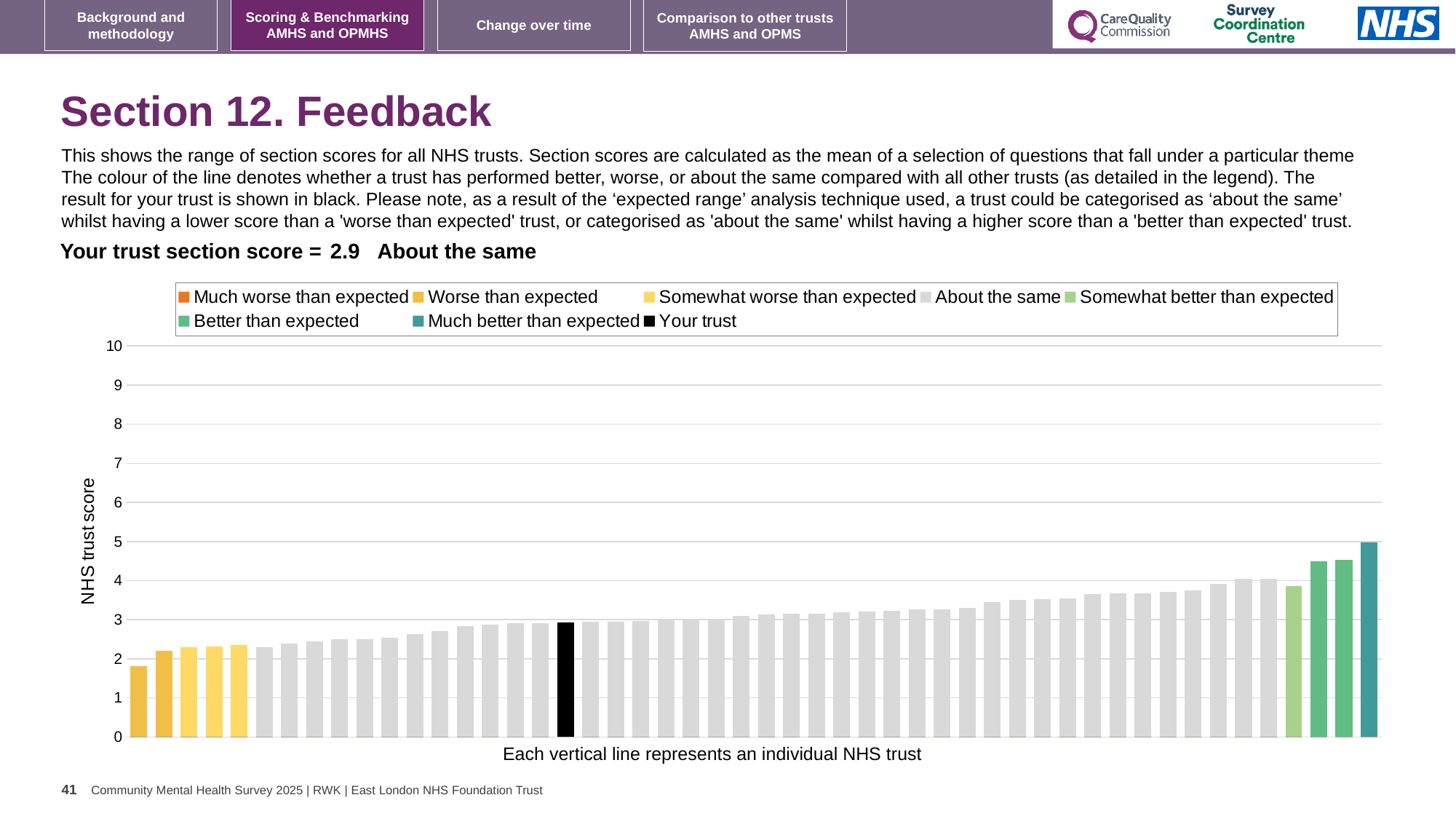
Is the value of the black 'Your trust' bar greater or less than 3? less What colour is used for the 'Your trust' bar in the chart? black What kind of chart is shown on the slide? bar chart What is the section score for your trust shown on the slide? 2.9 What is the label on the vertical axis of the chart? NHS trust score Is the value of the leftmost (shortest) bar greater or less than 2? less Is the value of the tallest bar in the chart greater or less than 4? greater Do the bar values rise or fall from left to right along the x axis? rise Which legend category does the tallest bar belong to? Much better than expected How many bars are coloured as 'Better than expected'? 2 How many entries does the chart legend list? 8 Which category is your trust placed in according to the slide? About the same